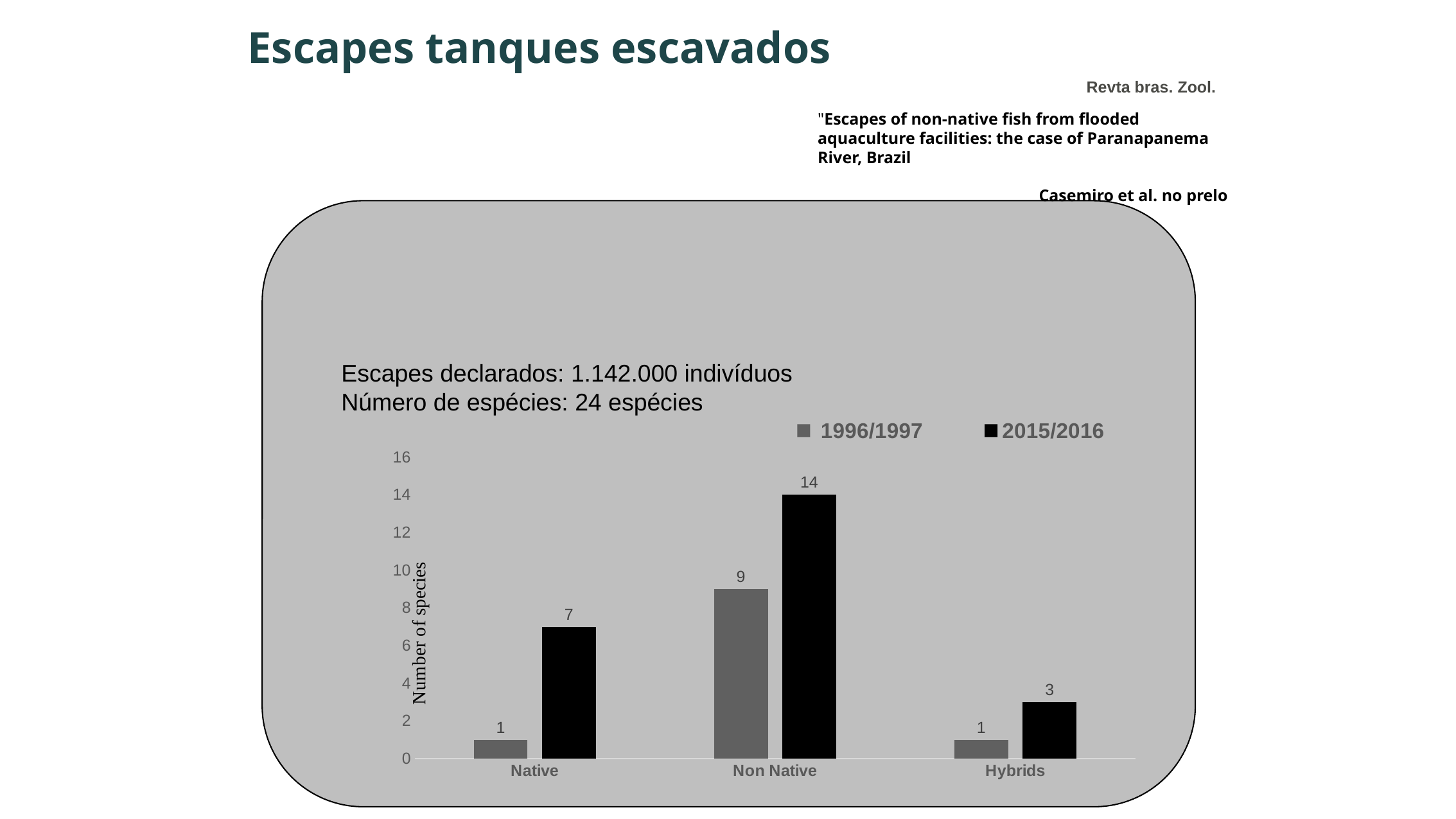
How many series does the legend list? 2 What is the difference between the 2015/2016 and 1996/1997 values for Native? 6 What is the number of species for Non Native in 1996/1997? 9 What is the number of species for Hybrids in 2015/2016? 3 How many categories are shown on the x axis? 3 Which category has the highest value in the 2015/2016 series? Non Native What is the label of the y axis? Number of species What kind of chart is shown on the slide? Bar chart Which category has the lowest value in the 2015/2016 series? Hybrids What is the number of species for Native in 1996/1997? 1 What is the number of species for Non Native in 2015/2016? 14 Which is larger: the 1996/1997 value for Non Native or the 2015/2016 value for Native? 1996/1997 value for Non Native